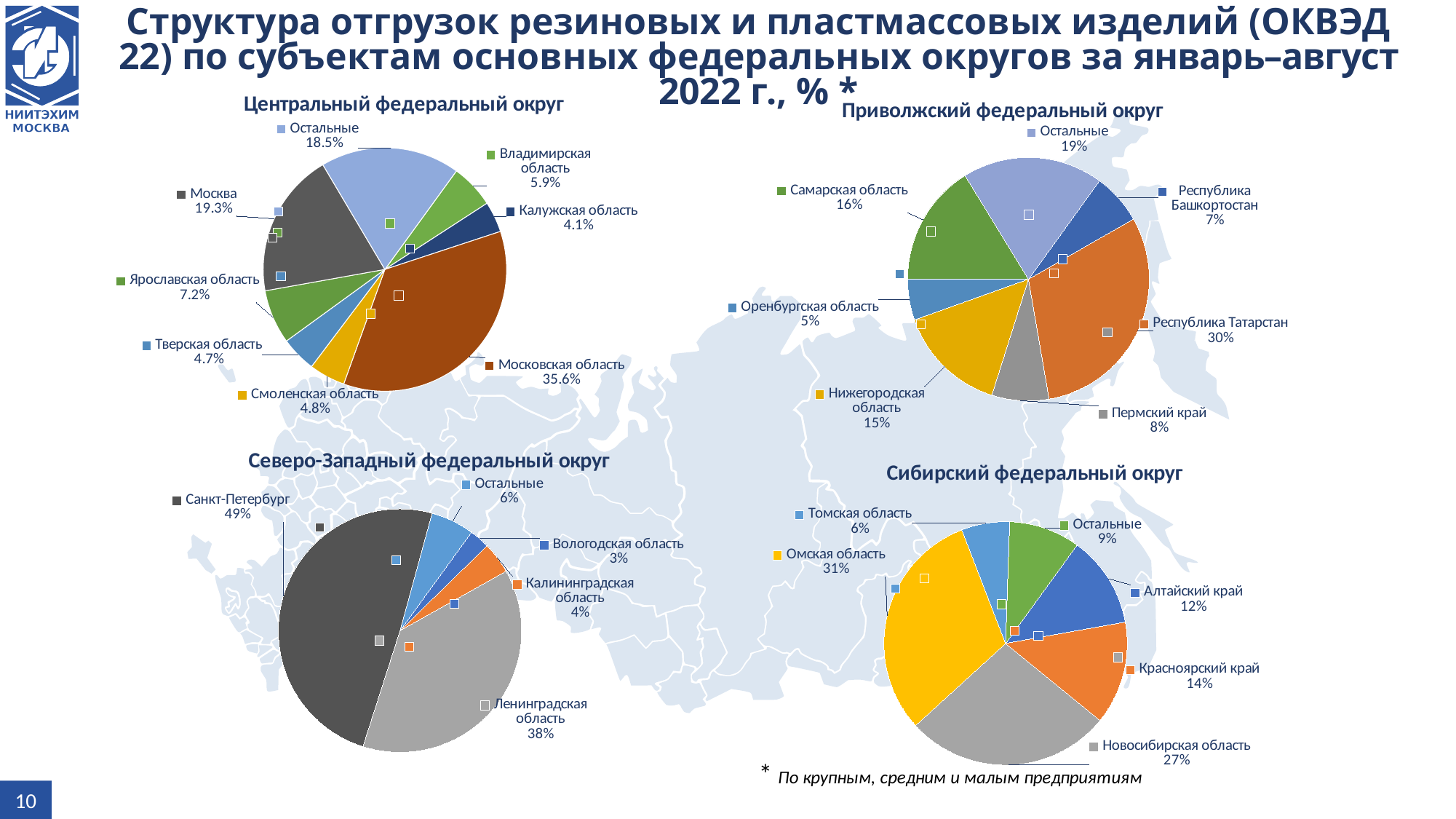
In the 'Сибирский федеральный округ' chart, what is the difference between the shares of Омская область and Новосибирская область? 4% In the 'Северо-Западный федеральный округ' chart, what share does Ленинградская область have? 38% In the 'Северо-Западный федеральный округ' chart, which category has the largest share? Санкт-Петербург In the 'Центральный федеральный округ' chart, which region has the smallest share? Калужская область In the 'Приволжский федеральный округ' chart, what share does Республика Татарстан have? 30% In the 'Центральный федеральный округ' chart, what is the difference between the shares of Москва and Ярославская область? 12.1% In the 'Центральный федеральный округ' chart, what share does Московская область have? 35.6% In the 'Приволжский федеральный округ' chart, which region has the smallest share? Оренбургская область What type of chart is used for 'Сибирский федеральный округ'? Pie chart How many slices does the 'Центральный федеральный округ' pie chart have? 8 In the 'Приволжский федеральный округ' chart, which is larger: Самарская область or Нижегородская область? Самарская область How many slices does the 'Северо-Западный федеральный округ' pie chart have? 5